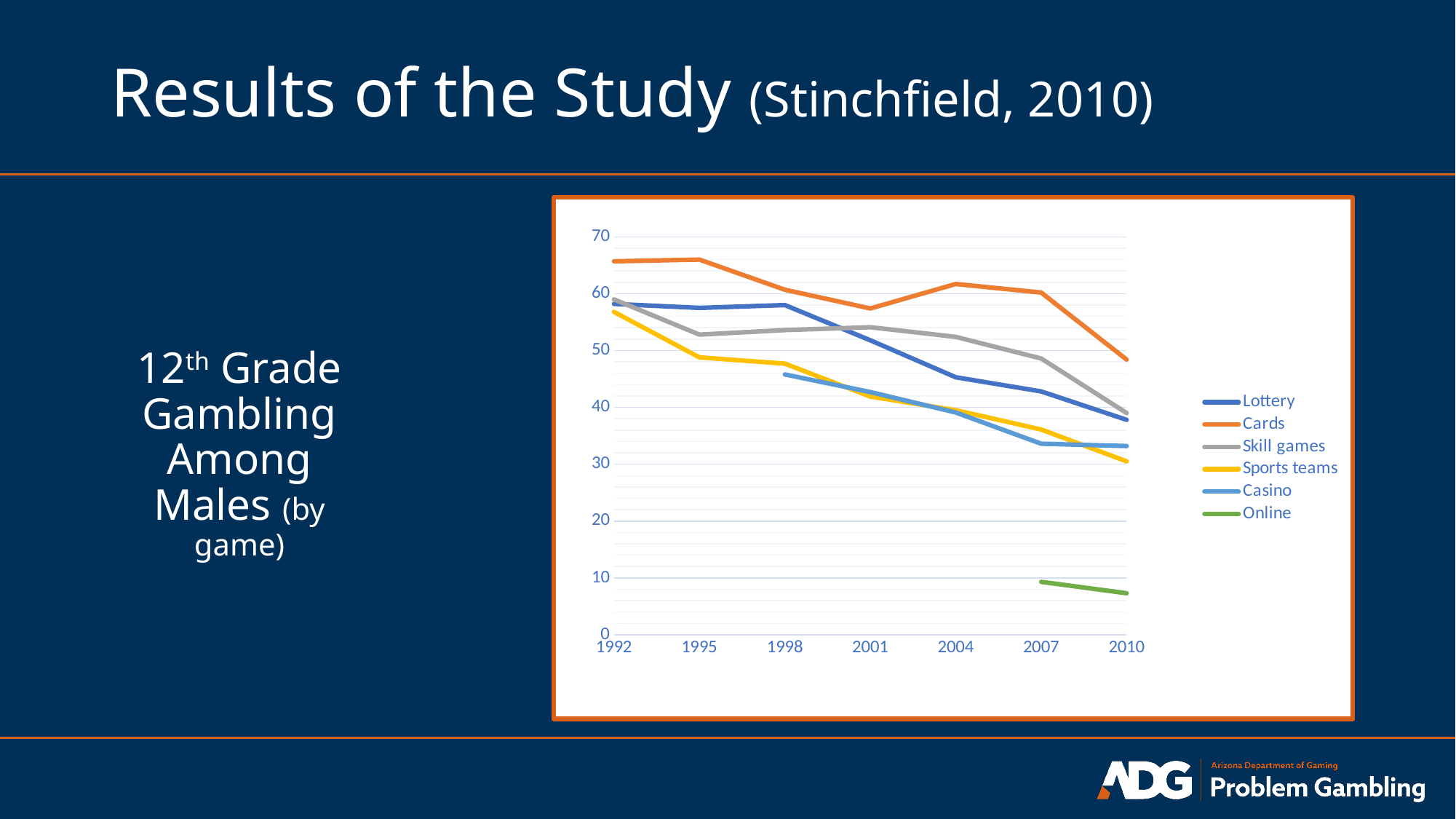
Is the value for Online in 2010 greater or less than 10? less Which series has the highest value in 1992? Cards Is the value for Casino in 2007 greater or less than 30? greater How many years are plotted along the x axis of the chart? 7 Does the Lottery series rise or fall from 1992 to 2010? fall Which series has the lowest value in 2010? Online Is the value for Sports teams in 2010 greater or less than 40? less How many series does the chart legend list? 6 What kind of chart is shown on the slide? line chart Which series is drawn in green in the chart? Online In 2004, which is larger: the value for Cards or the value for Lottery? Cards